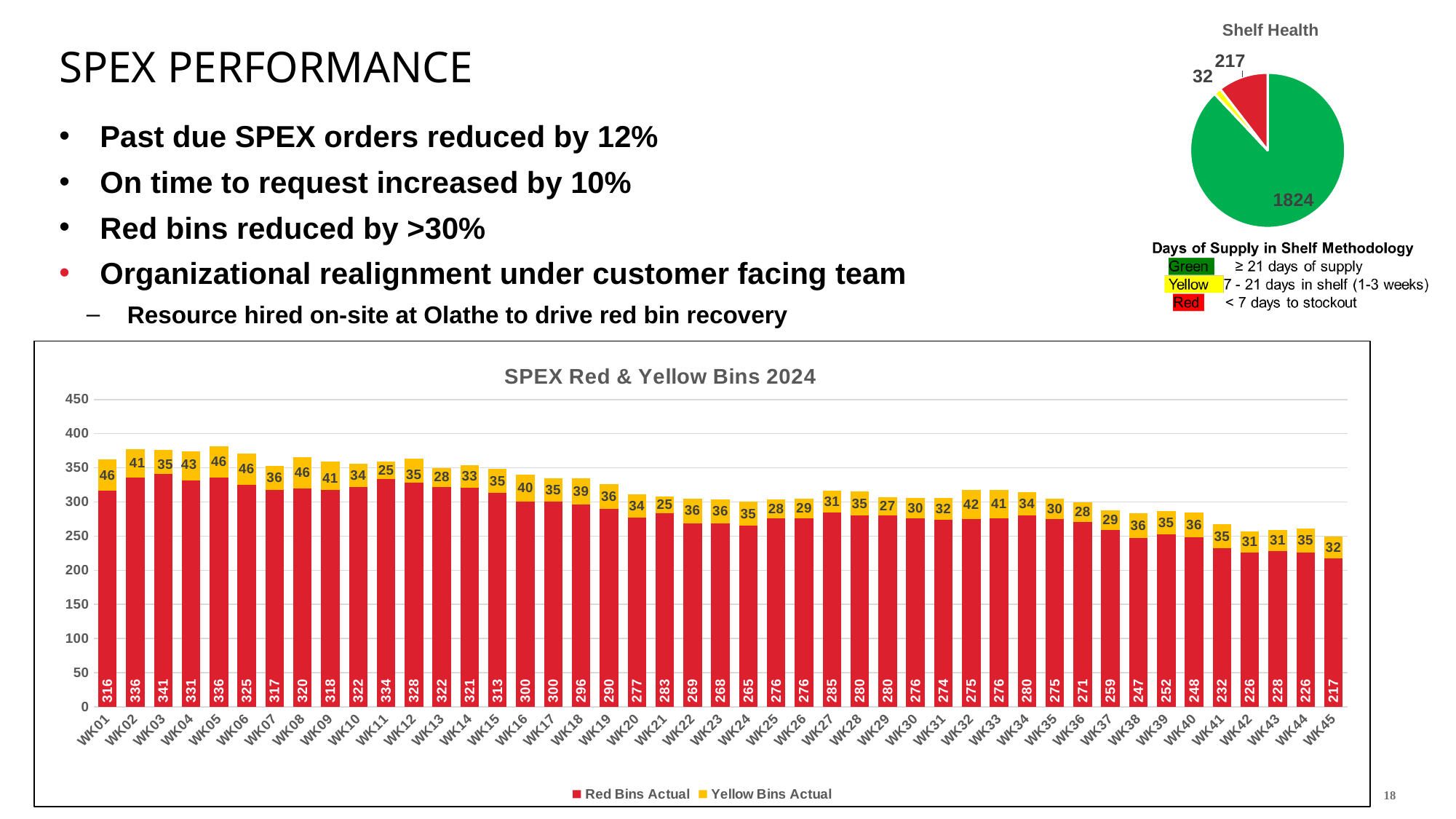
In the SPEX Red & Yellow Bins 2024 chart, do the Red Bins Actual values generally rise or fall from WK01 to WK45? Fall In the SPEX Red & Yellow Bins 2024 chart, which is larger, the Red Bins Actual value for WK02 or for WK20? WK02 How many weeks are shown on the x axis of the SPEX Red & Yellow Bins 2024 chart? 45 In the SPEX Red & Yellow Bins 2024 chart, what is the Yellow Bins Actual value for WK16? 40 What kind of chart is the SPEX Red & Yellow Bins 2024 chart? Stacked bar chart How many series does the legend of the SPEX Red & Yellow Bins 2024 chart list? 2 In the SPEX Red & Yellow Bins 2024 chart, what is the difference between the Red Bins Actual values for WK01 and WK45? 99 In the SPEX Red & Yellow Bins 2024 chart, what is the total of the stacked bar for WK45? 249 In the SPEX Red & Yellow Bins 2024 chart, what is the Red Bins Actual value for WK45? 217 In the SPEX Red & Yellow Bins 2024 chart, which week has the lowest Red Bins Actual value? WK45 In the SPEX Red & Yellow Bins 2024 chart, which week has the highest Red Bins Actual value? WK03 In the Shelf Health pie chart, what is the value of the green slice? 1824